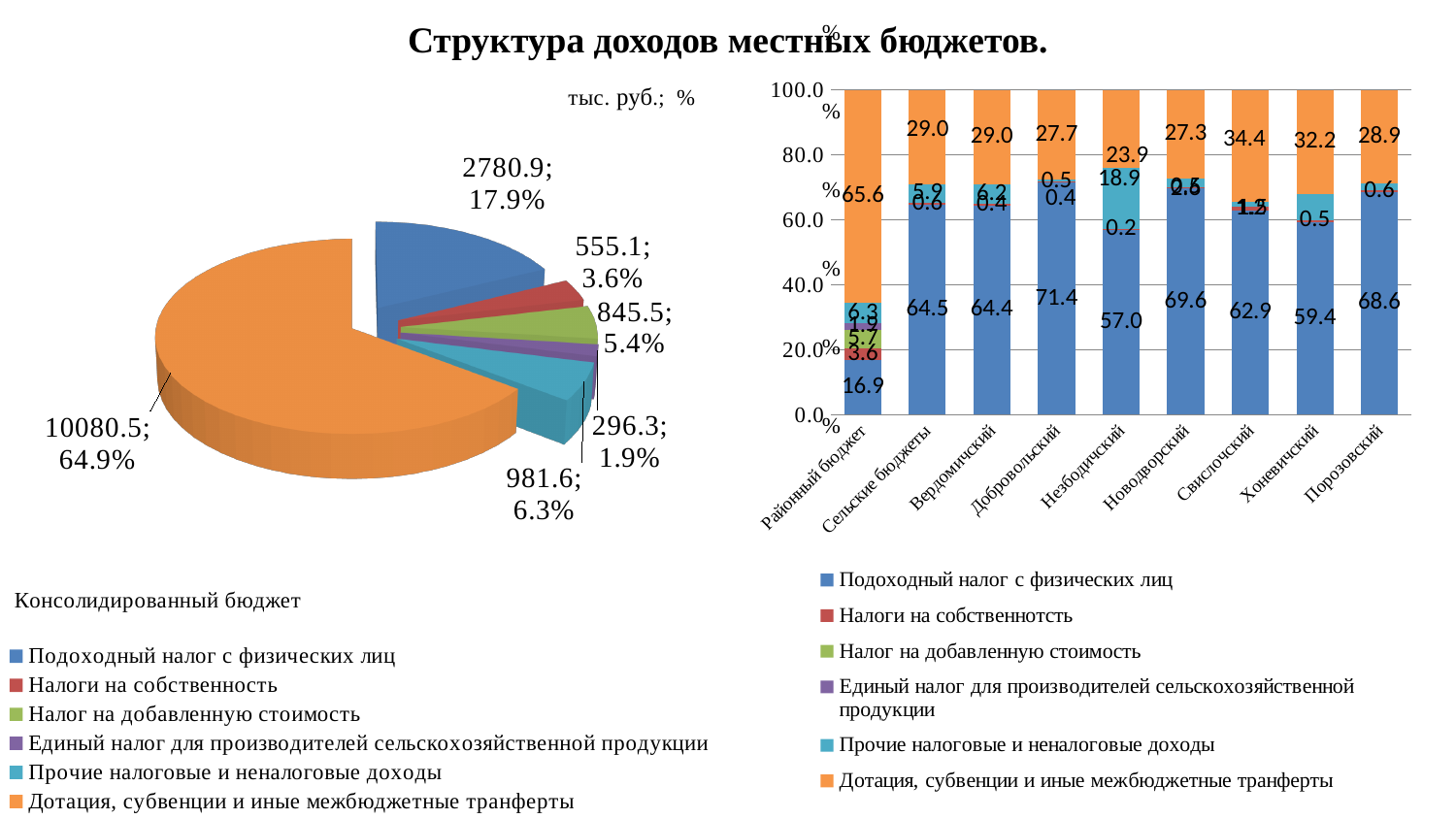
On the pie chart (Консолидированный бюджет), which category has the smallest slice? Единый налог для производителей сельскохозяйственной продукции On the stacked bar chart on the right, which category has the lowest value for Подоходный налог с физических лиц? Районный бюджет On the stacked bar chart on the right, how many series does the legend list? 6 On the pie chart (Консолидированный бюджет), how many slices are there? 6 On the pie chart (Консолидированный бюджет), what share does Подоходный налог с физических лиц have? 17.9% On the stacked bar chart on the right, what is the value of Подоходный налог с физических лиц for Добровольский? 71.4 On the stacked bar chart on the right, which is larger for Свислочский: Подоходный налог с физических лиц or Дотация, субвенции и иные межбюджетные трансферты? Подоходный налог с физических лиц What type of chart is on the left side of the slide? Pie chart On the pie chart (Консолидированный бюджет), what value and share are shown for Дотация, субвенции и иные межбюджетные трансферты? 10080.5; 64.9% On the stacked bar chart on the right, what is the value of Дотация, субвенции и иные межбюджетные трансферты for Районный бюджет? 65.6 On the pie chart (Консолидированный бюджет), what is the difference between the values for Прочие налоговые и неналоговые доходы (981.6) and Налоги на собственность (555.1)? 426.5 On the stacked bar chart on the right, how many categories are shown on the x axis? 9